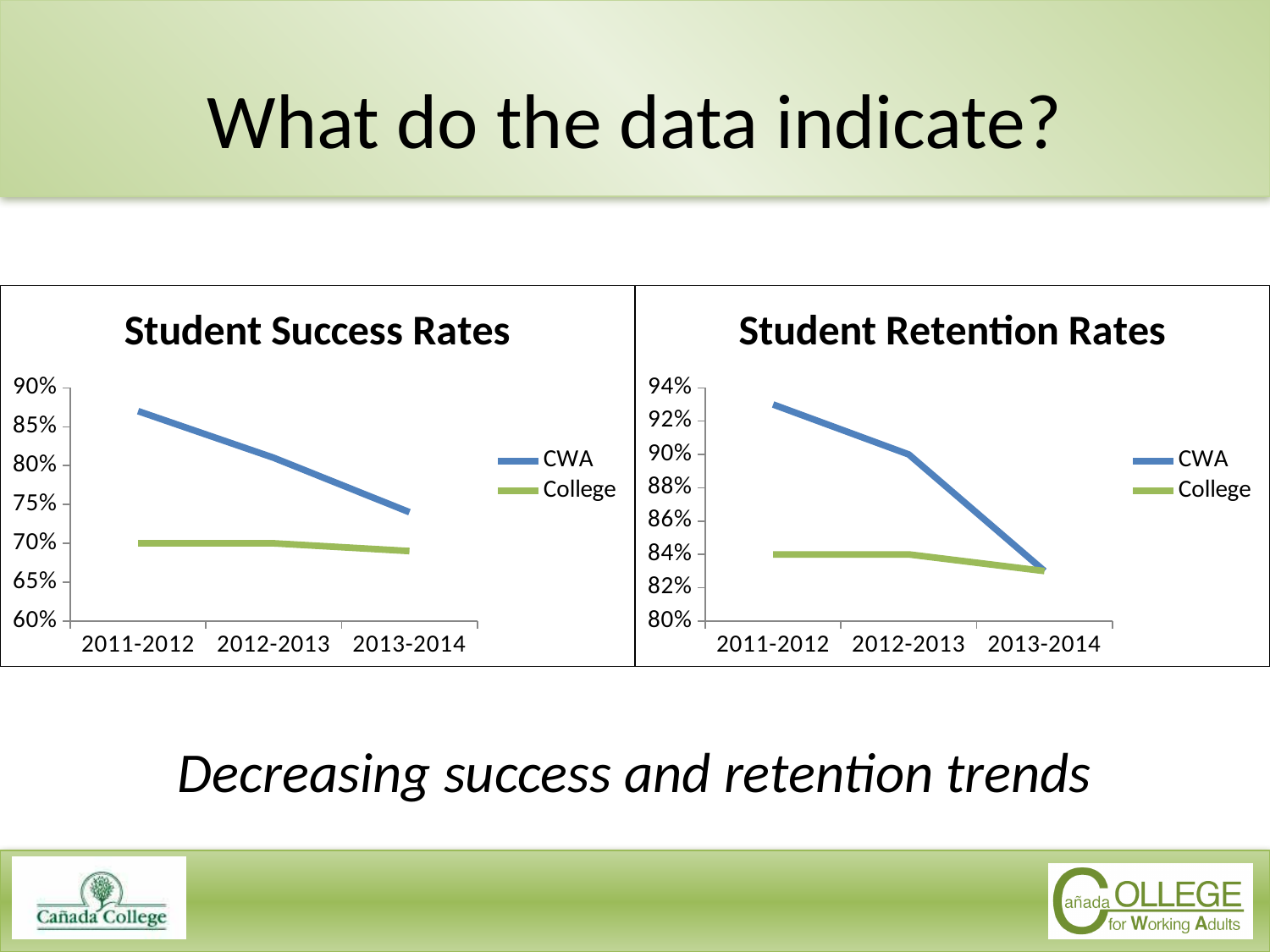
In the Student Success Rates chart, does the CWA line rise or fall from 2011-2012 to 2013-2014? fall In the Student Success Rates chart, which series is higher in 2012-2013, CWA or College? CWA What type of chart is the Student Success Rates chart? line chart In the Student Success Rates chart, is the CWA value for 2011-2012 greater or less than 85%? greater How many academic years are shown on the x axis of the Student Success Rates chart? 3 What are the two legend entries in the Student Success Rates chart? CWA and College In the Student Retention Rates chart, in which year is the CWA value lowest? 2013-2014 How many series does the legend of the Student Retention Rates chart list? 2 In the Student Retention Rates chart, is the College value for 2012-2013 greater or less than 86%? less In the Student Retention Rates chart, does the CWA line rise or fall across the years shown? fall In the Student Success Rates chart, is the CWA value for 2013-2014 greater or less than 75%? less